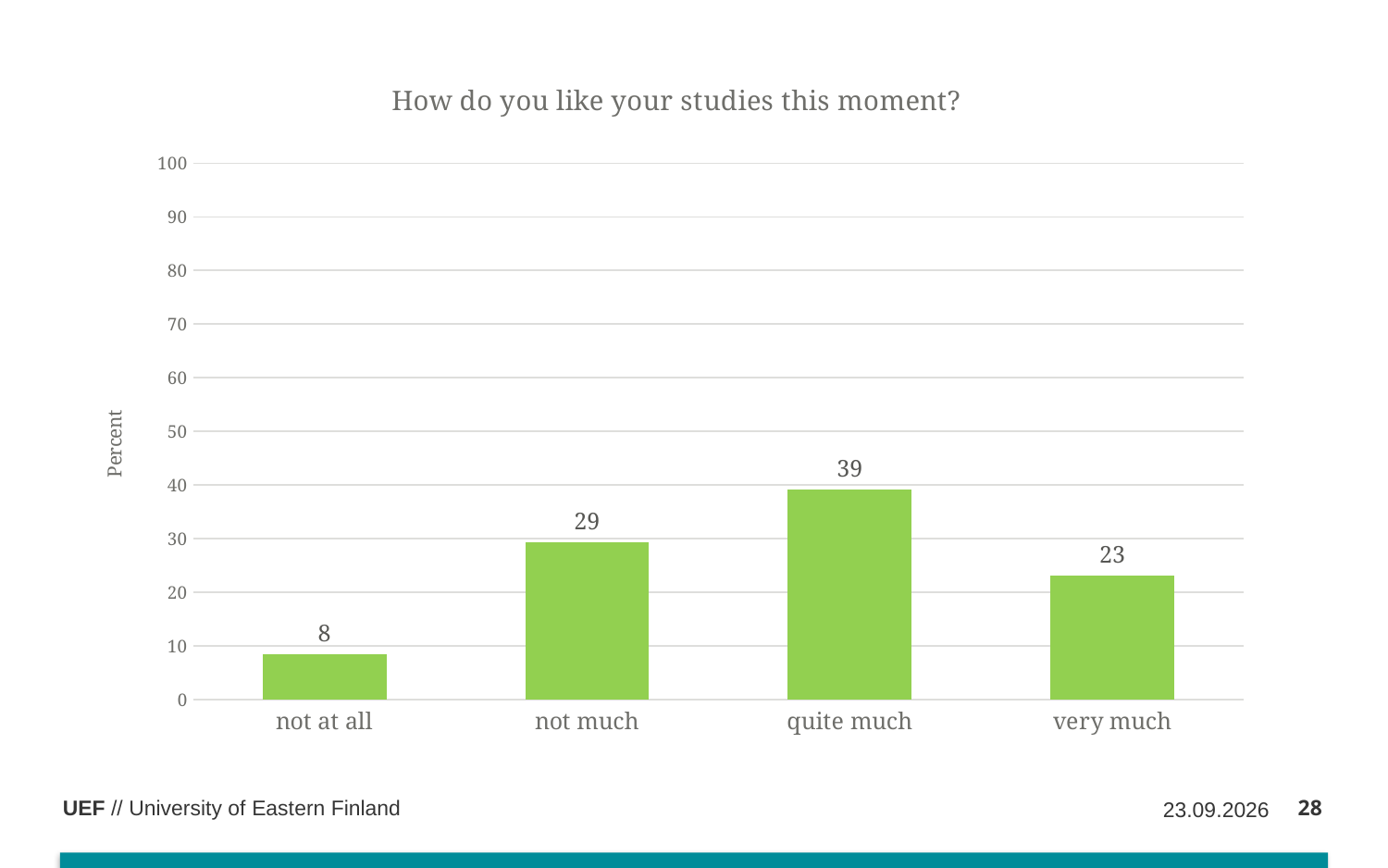
What kind of chart is shown on the slide? bar chart Is the value for "not much" greater or less than 20? greater What is the title of the chart? How do you like your studies this moment? What is the value for "very much"? 23 Which is larger, the value for "not much" or the value for "very much"? not much Which category has the highest value? quite much Which category has the lowest value? not at all How many categories are shown on the x axis? 4 What is the difference between the values for "quite much" and "not much"? 10 What is the value for "quite much"? 39 What is the value for "not at all"? 8 What is the label of the y axis? Percent